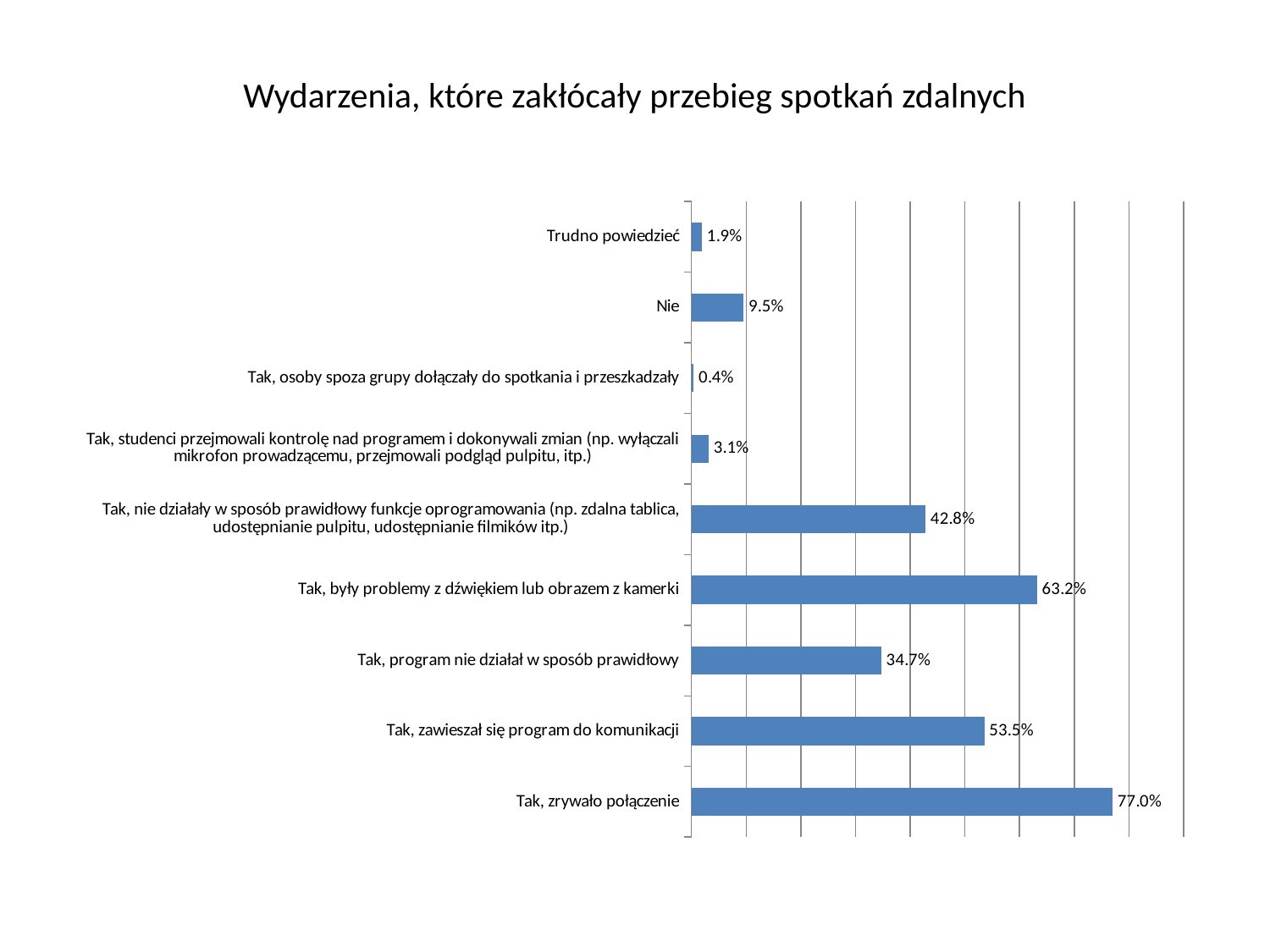
Which category has the highest value? Tak, zrywało połączenie What is the value for "Tak, program nie działał w sposób prawidłowy"? 34.7% What is the value for "Tak, były problemy z dźwiękiem lub obrazem z kamerki"? 63.2% What is the difference between the values for "Tak, zrywało połączenie" and "Tak, zawieszał się program do komunikacji"? 23.5% What is the title of the chart? Wydarzenia, które zakłócały przebieg spotkań zdalnych What is the value for "Tak, zrywało połączenie"? 77.0% Which category has the lowest value? Tak, osoby spoza grupy dołączały do spotkania i przeszkadzały What is the value for "Nie"? 9.5% How many categories are shown in the chart? 9 What kind of chart is shown on the slide? Bar chart Which is larger: the value for "Tak, zawieszał się program do komunikacji" or the value for "Tak, nie działały w sposób prawidłowy funkcje oprogramowania"? Tak, zawieszał się program do komunikacji What is the difference between the values for "Nie" and "Trudno powiedzieć"? 7.6%